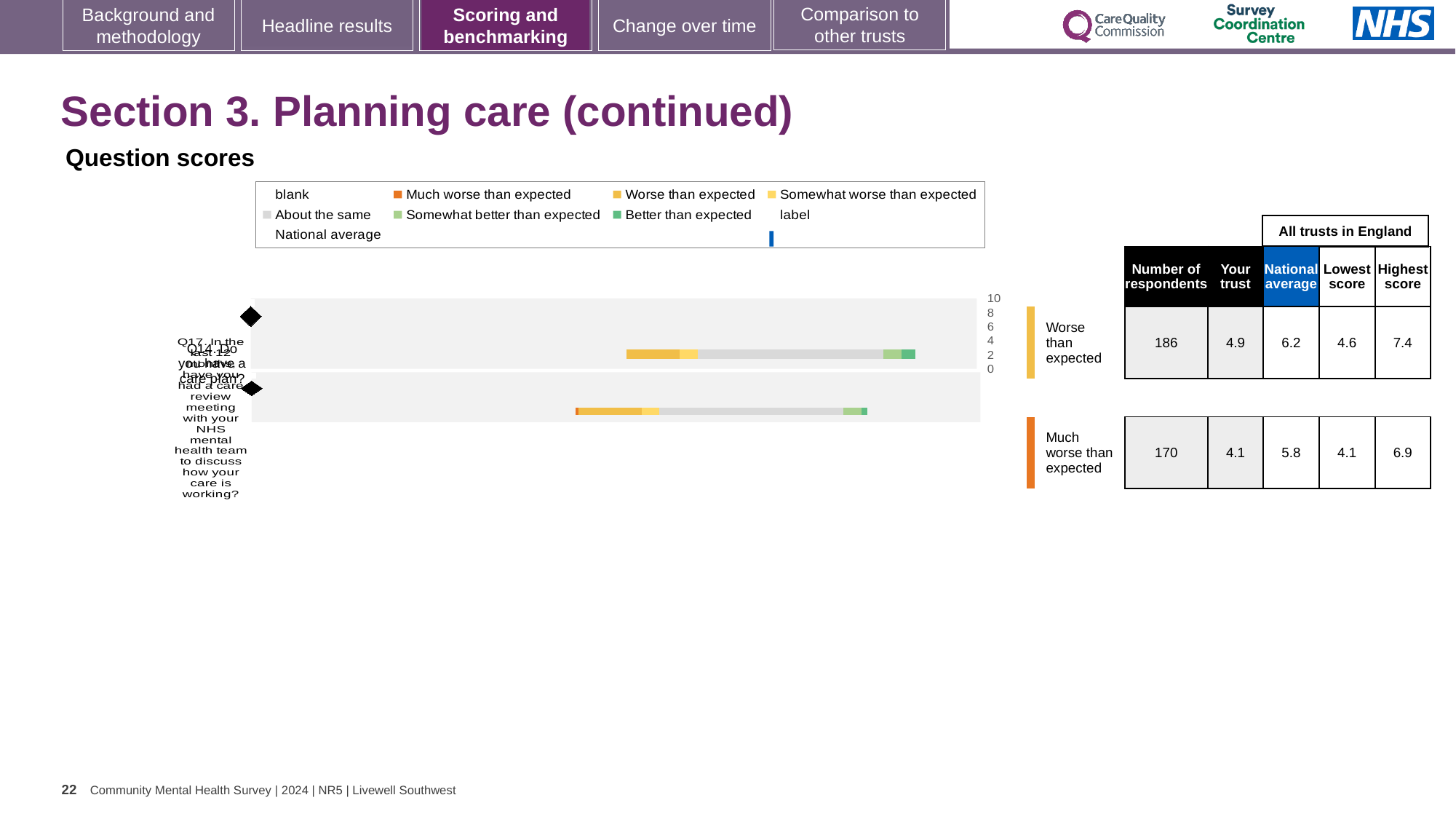
In the table beside the chart, what is the national average for Q14? 6.2 For Q14, how much lower is the trust score than the national average? 1.3 How many questions (bars) are plotted in the chart? 2 What kind of chart is shown on the slide? bar chart In the table beside the chart, what is the highest score for Q17? 6.9 Which question has the higher 'Your trust' score, Q14 or Q17? Q14 In the table beside the chart, what is the number of respondents for Q14 (Do you have a care plan?)? 186 What benchmark category is shown next to the chart for Q17? Much worse than expected In the table beside the chart, what is the 'Your trust' score for Q17 (care review meeting)? 4.1 Which question has more respondents, Q14 or Q17? Q14 In the table beside the chart, what is the lowest score for Q14? 4.6 For Q17, what is the difference between the national average and the trust score? 1.7